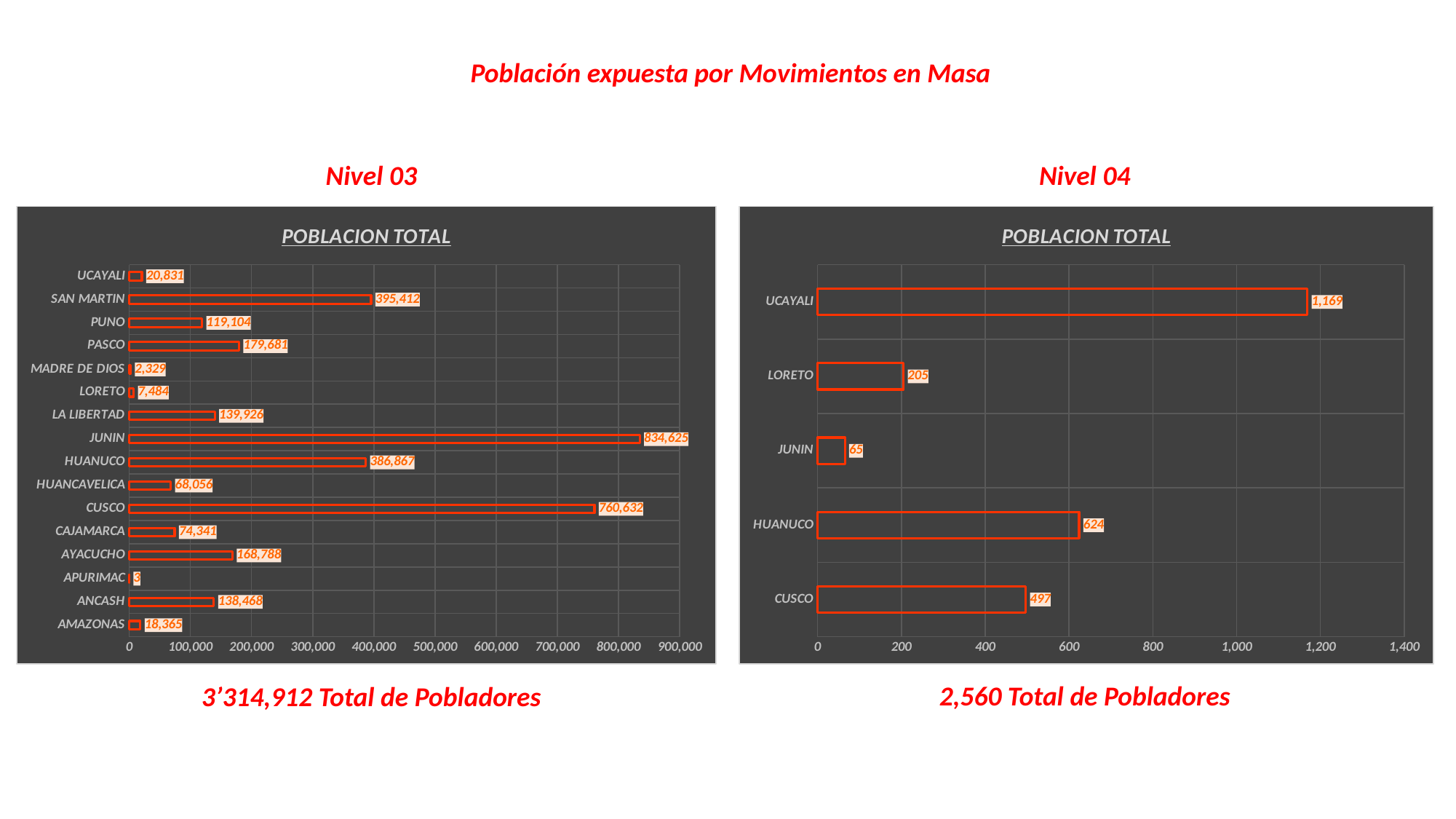
In the Nivel 04 chart, which region has the highest population? UCAYALI In the Nivel 03 chart, which region has the highest population? JUNIN In the Nivel 03 chart, what is the value for SAN MARTIN? 395,412 In the Nivel 04 chart, what is the value for HUANUCO? 624 In the Nivel 03 chart, which region has the lowest population? APURIMAC How many regions are shown in the Nivel 04 chart? 5 In the Nivel 03 chart, what is the value for JUNIN? 834,625 How many regions are shown in the Nivel 03 chart? 16 In the Nivel 03 chart, which is larger, CUSCO or HUANUCO? CUSCO In the Nivel 04 chart, which region has the lowest population? JUNIN What kind of chart is the Nivel 04 chart? Bar chart In the Nivel 04 chart, what is the difference between UCAYALI and CUSCO? 672